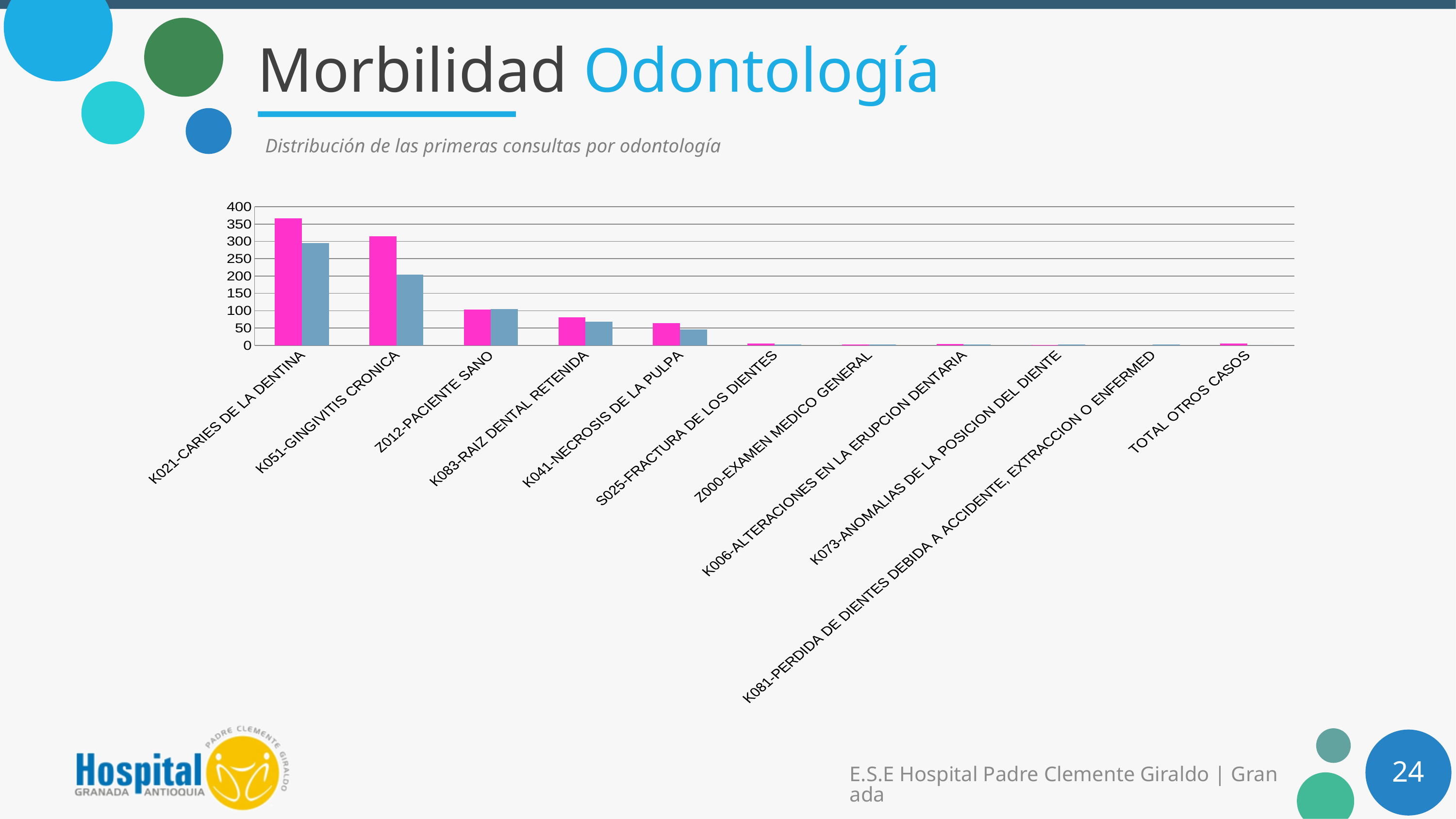
Is the value of the pink bar for K021-CARIES DE LA DENTINA greater or less than 300? greater Is the value of the pink bar for K051-GINGIVITIS CRONICA greater or less than 250? greater What kind of chart is shown on the slide? bar chart Is the value of the blue-grey bar for K051-GINGIVITIS CRONICA greater or less than 150? greater Do the bar values generally rise or fall moving from left to right along the x axis? fall How many categories are shown on the x axis of the chart? 11 Which category has the tallest bar in the chart? K021-CARIES DE LA DENTINA What is the subtitle printed above the chart? Distribución de las primeras consultas por odontología Which pink bar is larger, K021-CARIES DE LA DENTINA or K051-GINGIVITIS CRONICA? K021-CARIES DE LA DENTINA